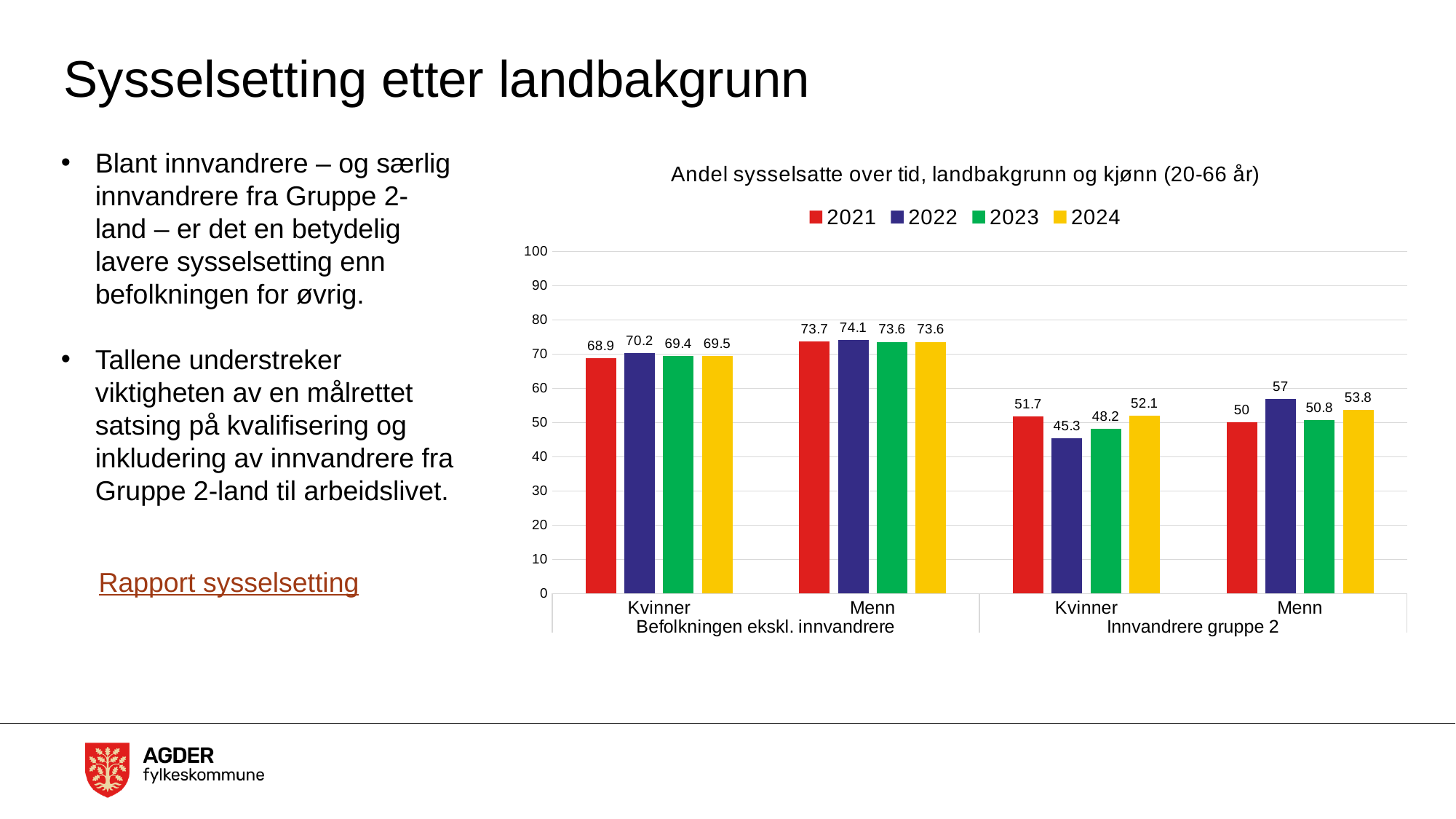
What is the value for 2023 for Kvinner in Innvandrere gruppe 2? 48.2 What colour represents the 2024 series in the chart? Yellow What is the title of the chart? Andel sysselsatte over tid, landbakgrunn og kjønn (20-66 år) What is the value for 2022 for Menn in Befolkningen ekskl. innvandrere? 74.1 Which year has the highest value for Kvinner in Innvandrere gruppe 2? 2024 Which is larger: the 2022 value for Kvinner in Innvandrere gruppe 2 or the 2022 value for Menn in Innvandrere gruppe 2? Menn What is the value for 2021 for Menn in Innvandrere gruppe 2? 50 Is the 2021 value for Kvinner in Befolkningen ekskl. innvandrere greater or less than 60? greater What is the difference between the 2024 values for Menn and Kvinner in Innvandrere gruppe 2? 1.7 How many series does the legend list? 4 What kind of chart is shown on the slide? Bar chart Which year has the lowest value for Kvinner in Befolkningen ekskl. innvandrere? 2021